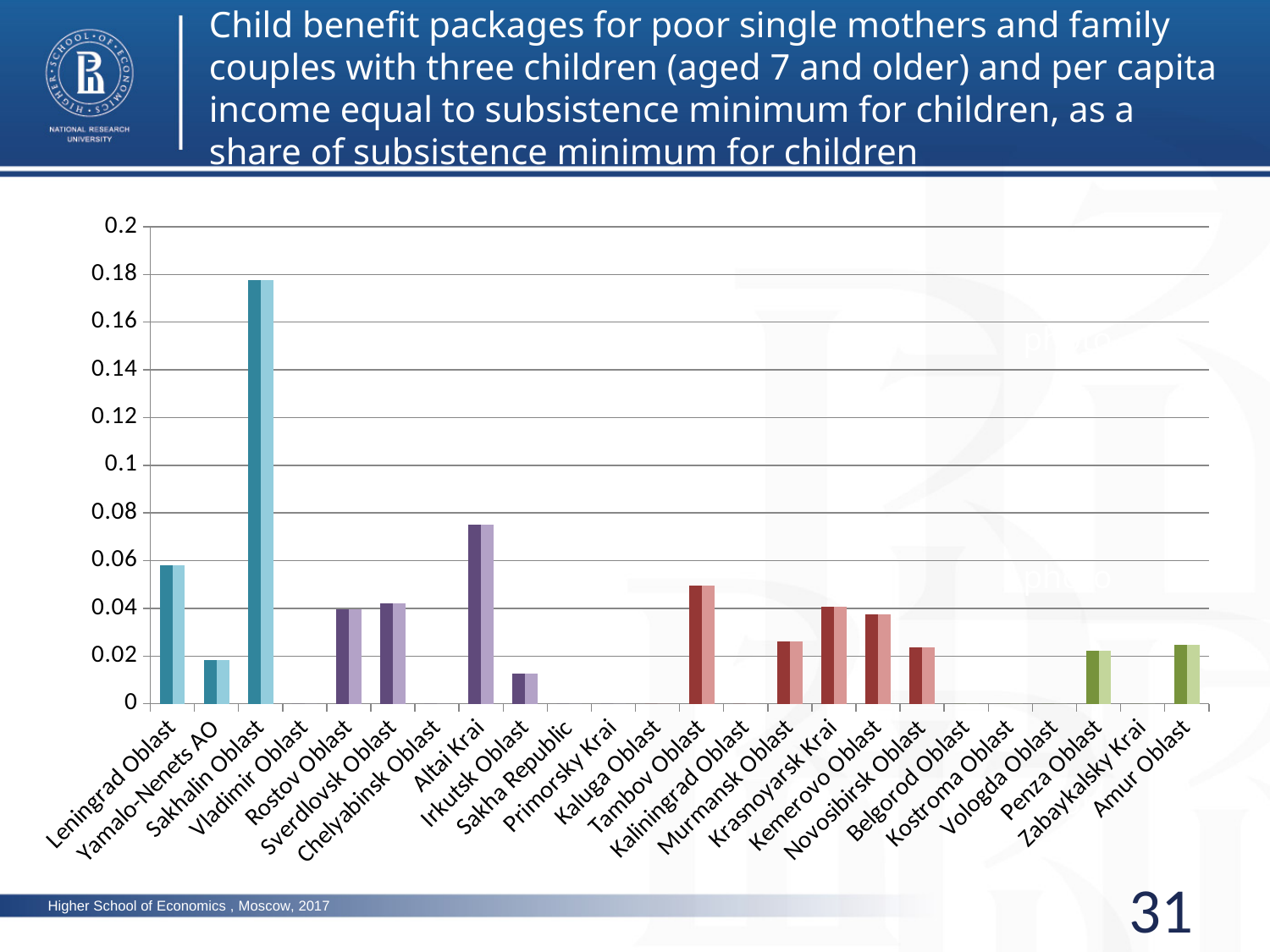
Which is larger, the value for Altai Krai or the value for Tambov Oblast? Altai Krai What is the highest value shown on the y axis of the chart? 0.2 Which is larger, the value for Leningrad Oblast or the value for Yamalo-Nenets AO? Leningrad Oblast What kind of chart is shown on the slide? bar chart Is the value for Altai Krai greater or less than 0.06? greater How many regions (categories) are listed along the x axis of the chart? 24 Is the value for Yamalo-Nenets AO greater or less than 0.04? less Is the value for Irkutsk Oblast greater or less than 0.02? less Which is larger, the value for Sakhalin Oblast or the value for Altai Krai? Sakhalin Oblast Which region has the highest value in the chart? Sakhalin Oblast